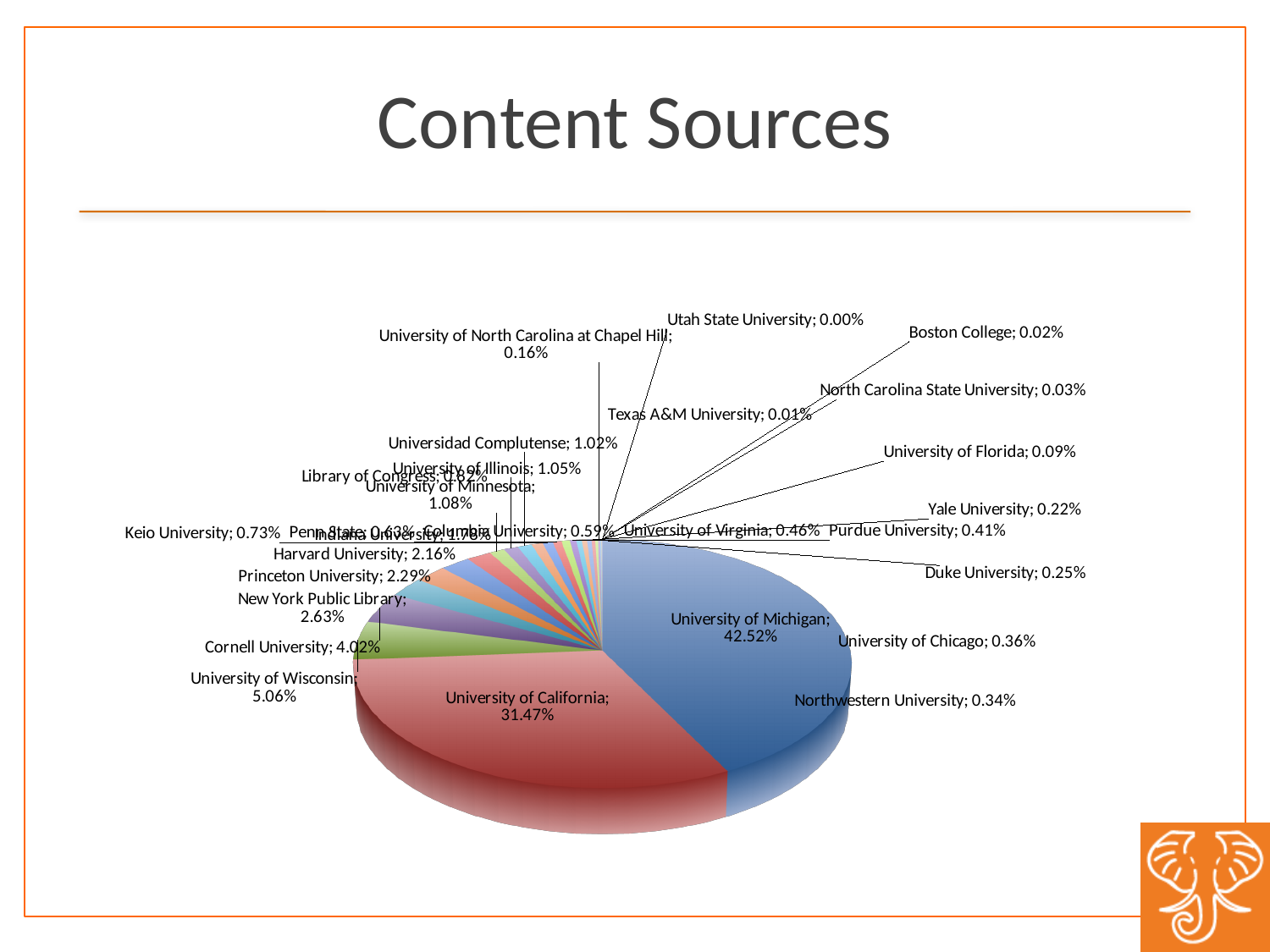
What kind of chart is shown on the slide? pie chart What is the value shown for Boston College? 0.02% What is the value shown for University of California? 31.47% What is the difference between the shares of University of Michigan and University of California? 11.05% Which content source has the largest slice of the pie? University of Michigan Which content source has the smallest share, at 0.00%? Utah State University What share of the pie does University of Michigan hold? 42.52% What is the value shown for Cornell University? 4.02% What is the value shown for University of Wisconsin? 5.06% Which is larger, the share for University of Wisconsin or for Cornell University? University of Wisconsin What is the combined share of University of Michigan and University of California? 73.99% What is the title of the chart on the slide? Content Sources